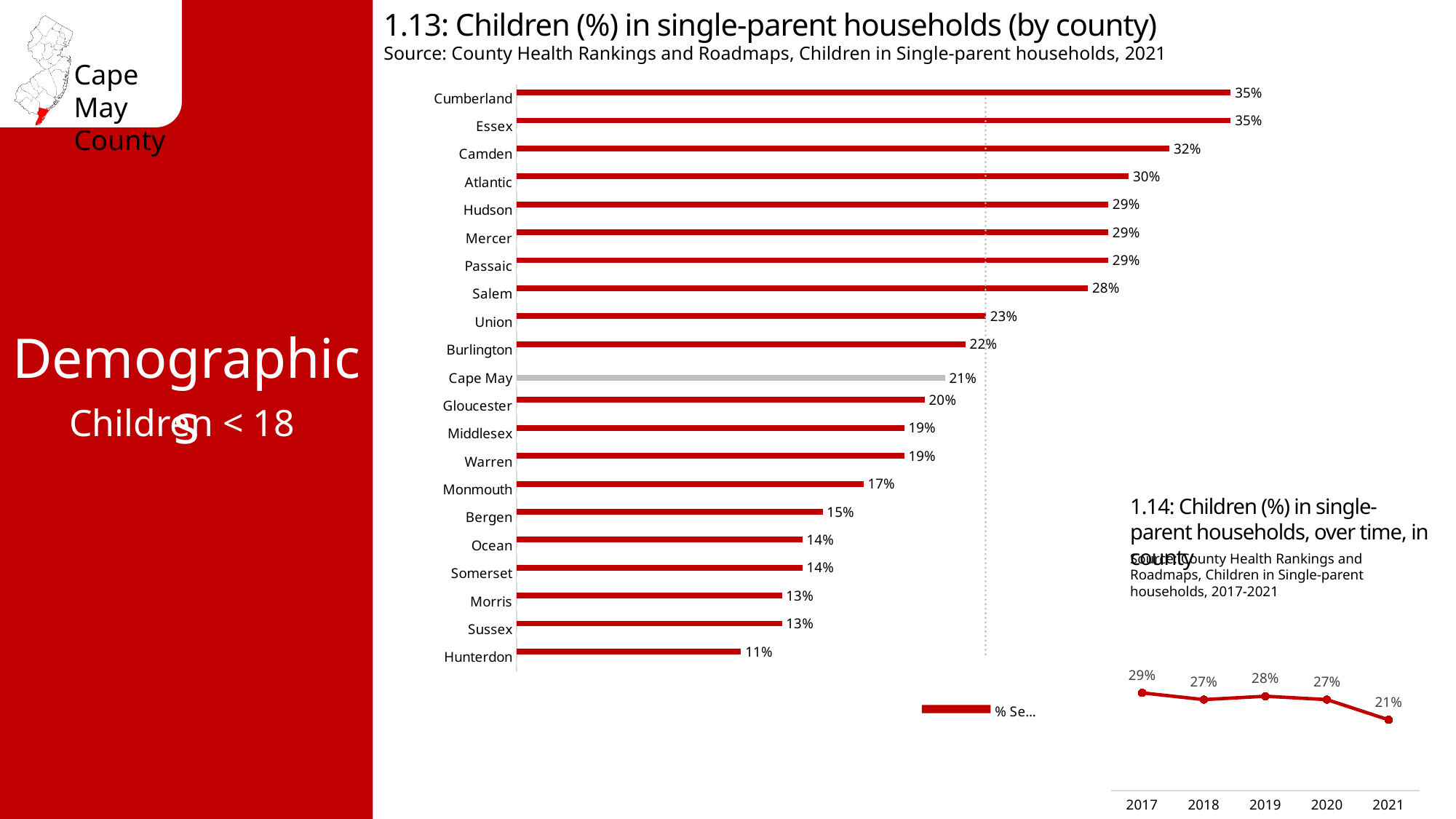
In chart 1.14 (over time, in county), do the values generally rise or fall from 2017 to 2021? Fall In chart 1.13 (by county), how many counties are shown? 21 In chart 1.13 (by county), which county has the lowest value? Hunterdon In chart 1.13 (by county), what is the value for Atlantic? 30% In chart 1.13 (by county), which is larger, the value for Salem or the value for Union? Salem In chart 1.14 (over time, in county), what is the value for 2019? 28% What kind of chart is chart 1.13 (by county)? Bar chart In chart 1.13 (Children (%) in single-parent households by county), what is the value for Cape May? 21% In chart 1.13 (by county), which bar is shown in grey rather than red? Cape May In chart 1.14 (over time, in county), what is the difference between 2017 and 2021? 8% In chart 1.13 (by county), what is the difference between Cumberland and Cape May? 14% In chart 1.14 (over time, in county), which year has the lowest value? 2021